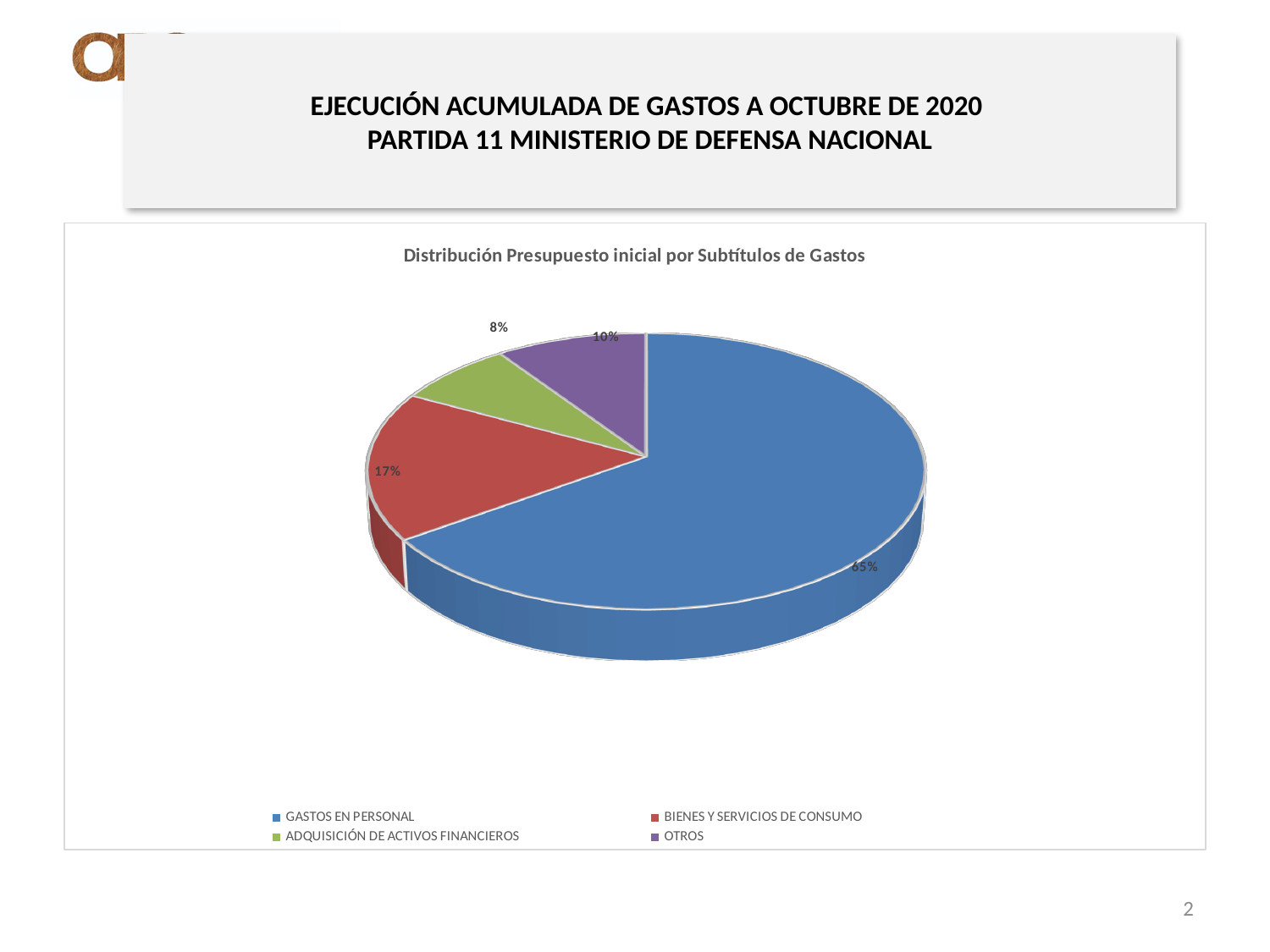
What is the difference in percentage points between GASTOS EN PERSONAL and BIENES Y SERVICIOS DE CONSUMO? 48 What is the title of the chart? Distribución Presupuesto inicial por Subtítulos de Gastos What share of the pie does BIENES Y SERVICIOS DE CONSUMO represent? 17% What kind of chart is shown on the slide? Pie chart What share of the pie does ADQUISICIÓN DE ACTIVOS FINANCIEROS represent? 8% Which category has the smallest slice of the pie? ADQUISICIÓN DE ACTIVOS FINANCIEROS What share of the pie does GASTOS EN PERSONAL represent? 65% What colour is the slice for BIENES Y SERVICIOS DE CONSUMO? Red Which category has the largest slice of the pie? GASTOS EN PERSONAL How many categories does the pie chart show? 4 Which is larger, the share for OTROS or the share for ADQUISICIÓN DE ACTIVOS FINANCIEROS? OTROS